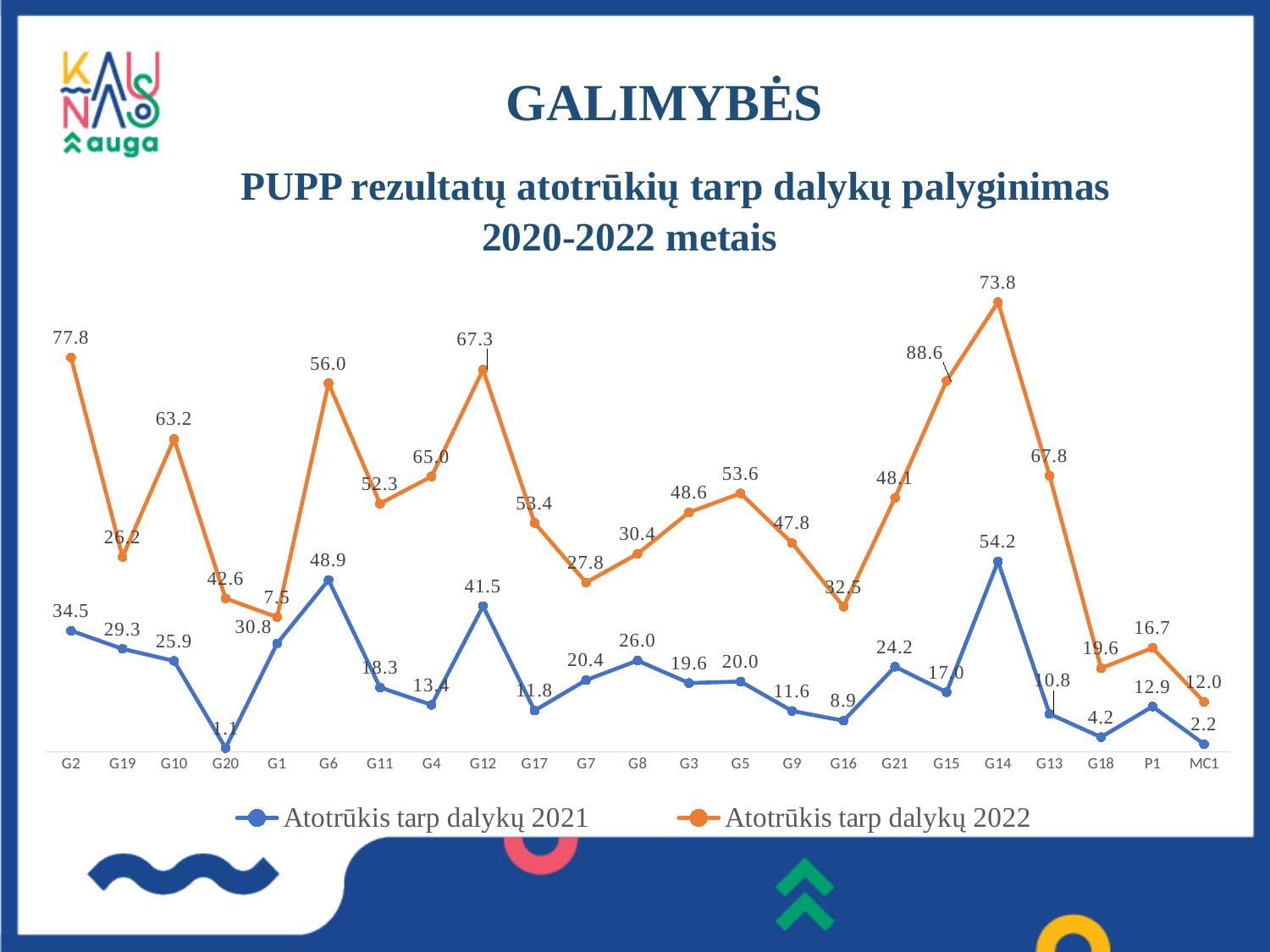
What is the value of 'Atotrūkis tarp dalykų 2022' for G12? 67.3 How many series does the legend list? 2 How many categories are shown on the x axis? 23 What are the two legend entries of the chart? Atotrūkis tarp dalykų 2021 and Atotrūkis tarp dalykų 2022 What is the difference between the 'Atotrūkis tarp dalykų 2021' values for G6 and G11? 30.6 What is the value of 'Atotrūkis tarp dalykų 2021' for G2? 34.5 What kind of chart is shown on the slide? line chart Which category has the highest value for 'Atotrūkis tarp dalykų 2021'? G14 What is the value of 'Atotrūkis tarp dalykų 2022' for MC1? 12.0 Which is larger for 'Atotrūkis tarp dalykų 2021': G8 or G3? G8 What is the value of 'Atotrūkis tarp dalykų 2021' for G18? 4.2 Which category has the lowest value for 'Atotrūkis tarp dalykų 2021'? G20